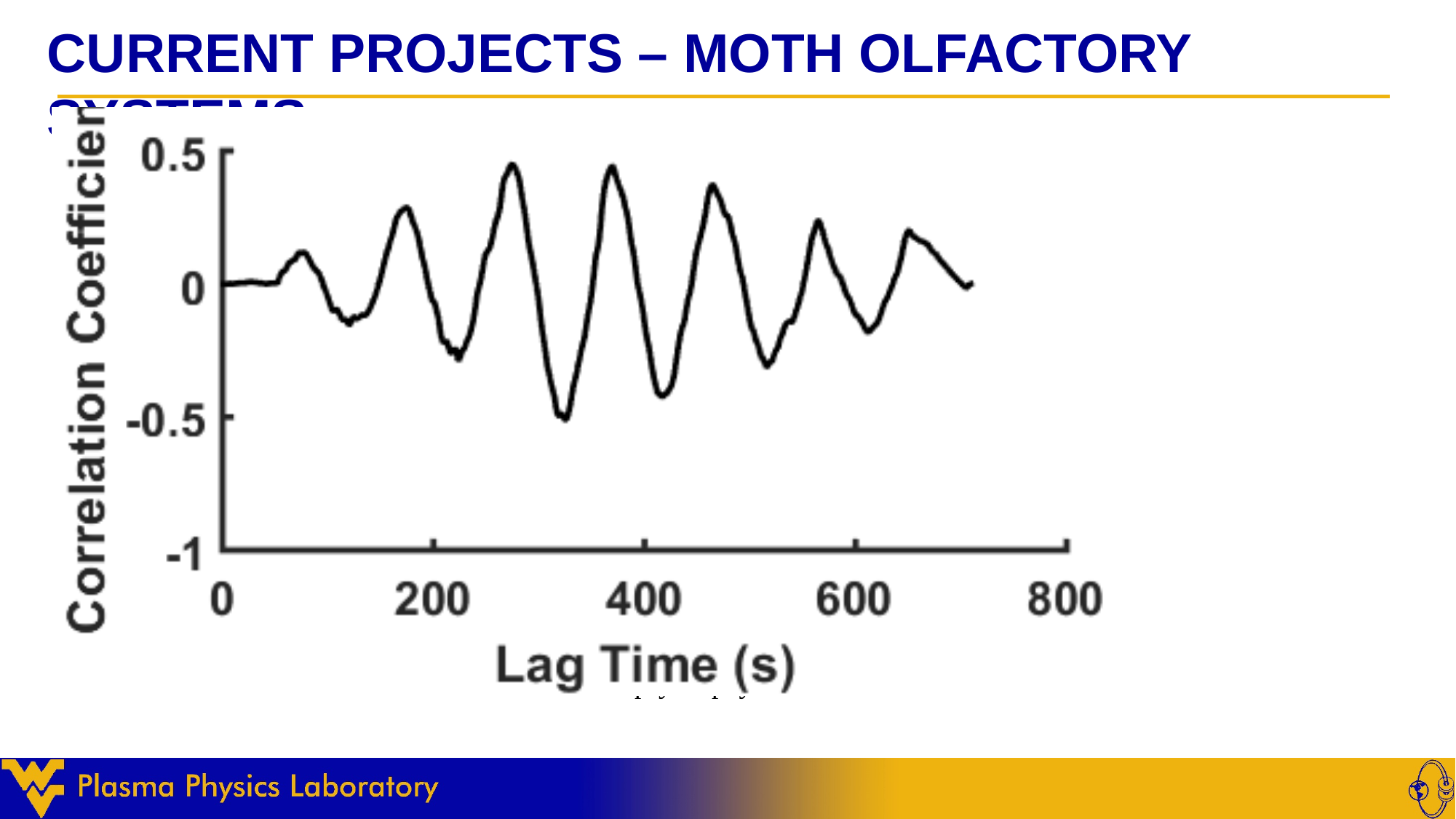
What is the label of the x axis of the chart? Lag Time (s) Is the value of the line at a lag time of about 280 s greater or less than 0? greater How many lines (series) are plotted on the chart? 1 Is the value of the correlation coefficient at a lag time of 0 s greater or less than 0.5? less Is the lowest point of the line greater or less than 0? less What is the largest value shown on the x axis of the chart? 800 What is the label of the y axis of the chart? Correlation Coefficient What kind of chart is shown on the slide? line chart